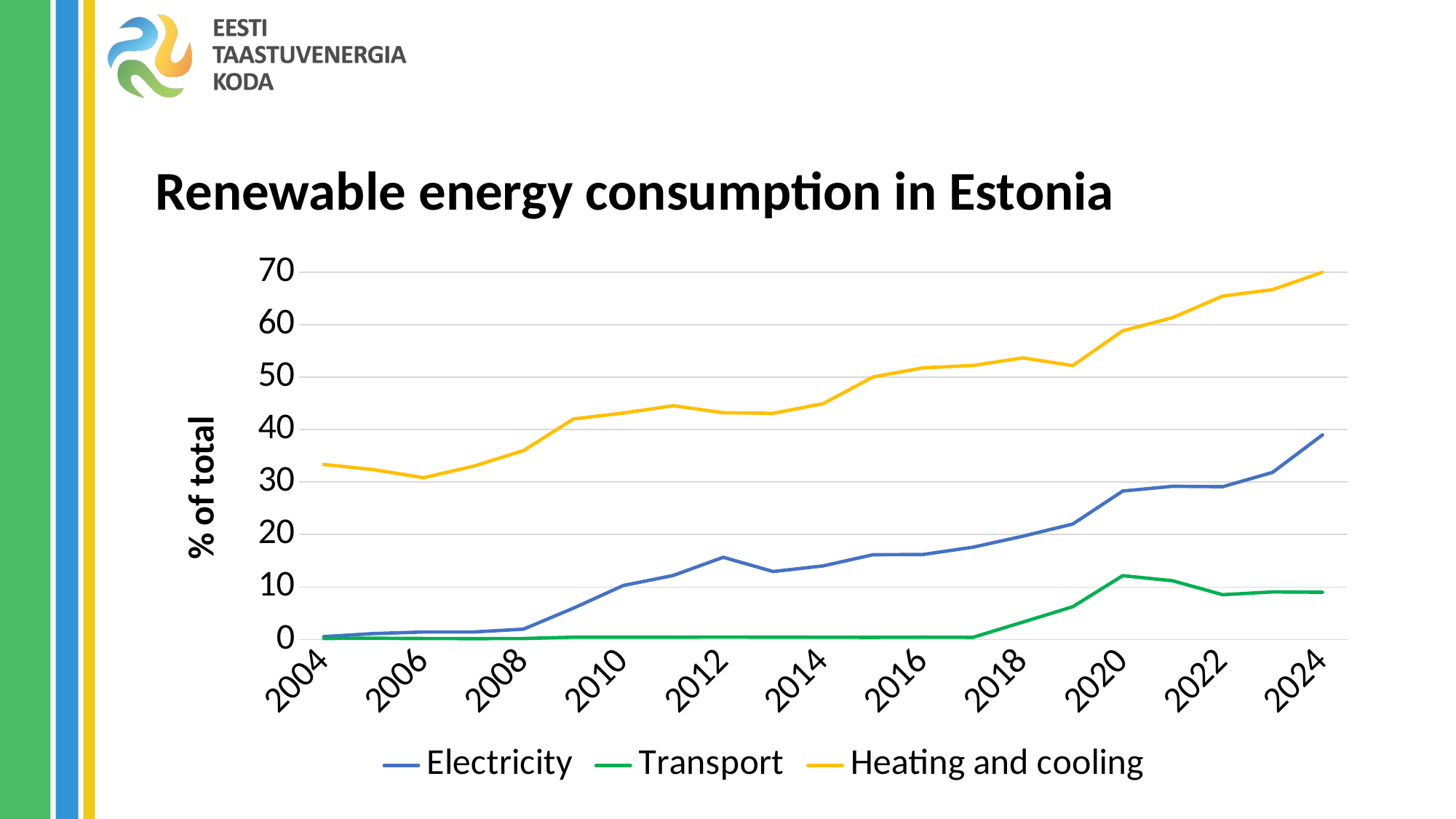
Is the value for Heating and cooling in 2020 greater or less than 50? greater Is the value for Electricity in 2024 greater or less than 30? greater Is the value for Transport in 2016 greater or less than 10? less What is the label of the y axis? % of total Does the Heating and cooling series generally rise or fall from 2004 to 2024? Rise Which is larger in 2012, the value for Electricity or the value for Transport? Electricity Which series has the highest value in 2024? Heating and cooling What type of chart is shown on the slide? Line chart Which series has the lowest value in 2024? Transport How many years are labelled on the x axis? 11 How many series does the legend list? 3